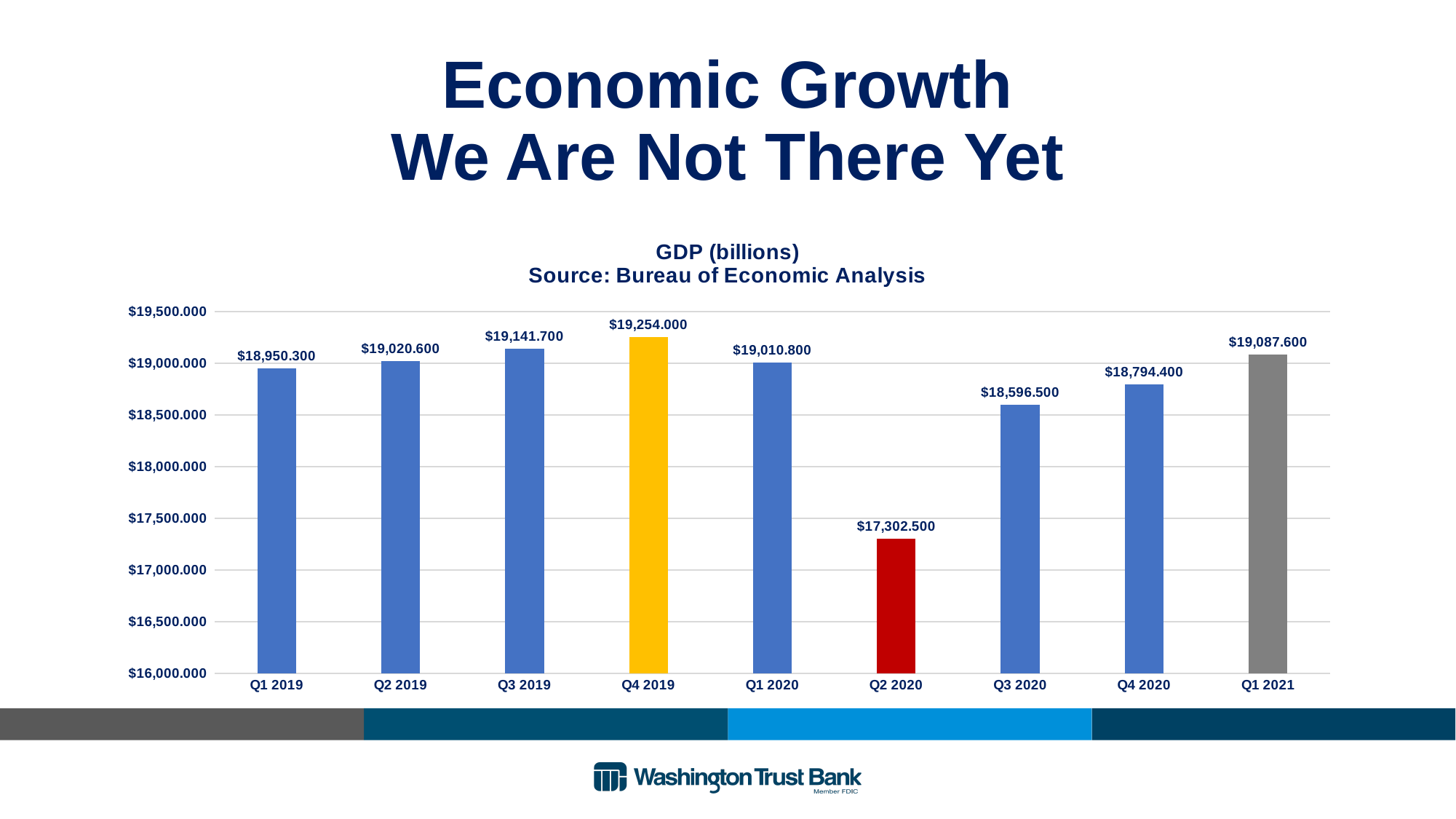
Which quarter has the lowest GDP value? Q2 2020 Which quarter has the highest GDP value? Q4 2019 What kind of chart is shown on the slide? Bar chart What is the difference between the GDP values for Q4 2019 and Q2 2020? $1,951.500 What is the difference between the GDP values for Q1 2021 and Q4 2020? $293.200 What is the GDP value for Q2 2020? $17,302.500 What is the GDP value for Q4 2019? $19,254.000 What colour is the bar for Q2 2020? Red How many quarters are shown on the chart? 9 Which is larger, the GDP value for Q1 2021 or Q4 2019? Q4 2019 What is the GDP value for Q1 2021? $19,087.600 Is the GDP value for Q3 2020 greater or less than $18,500.000? greater